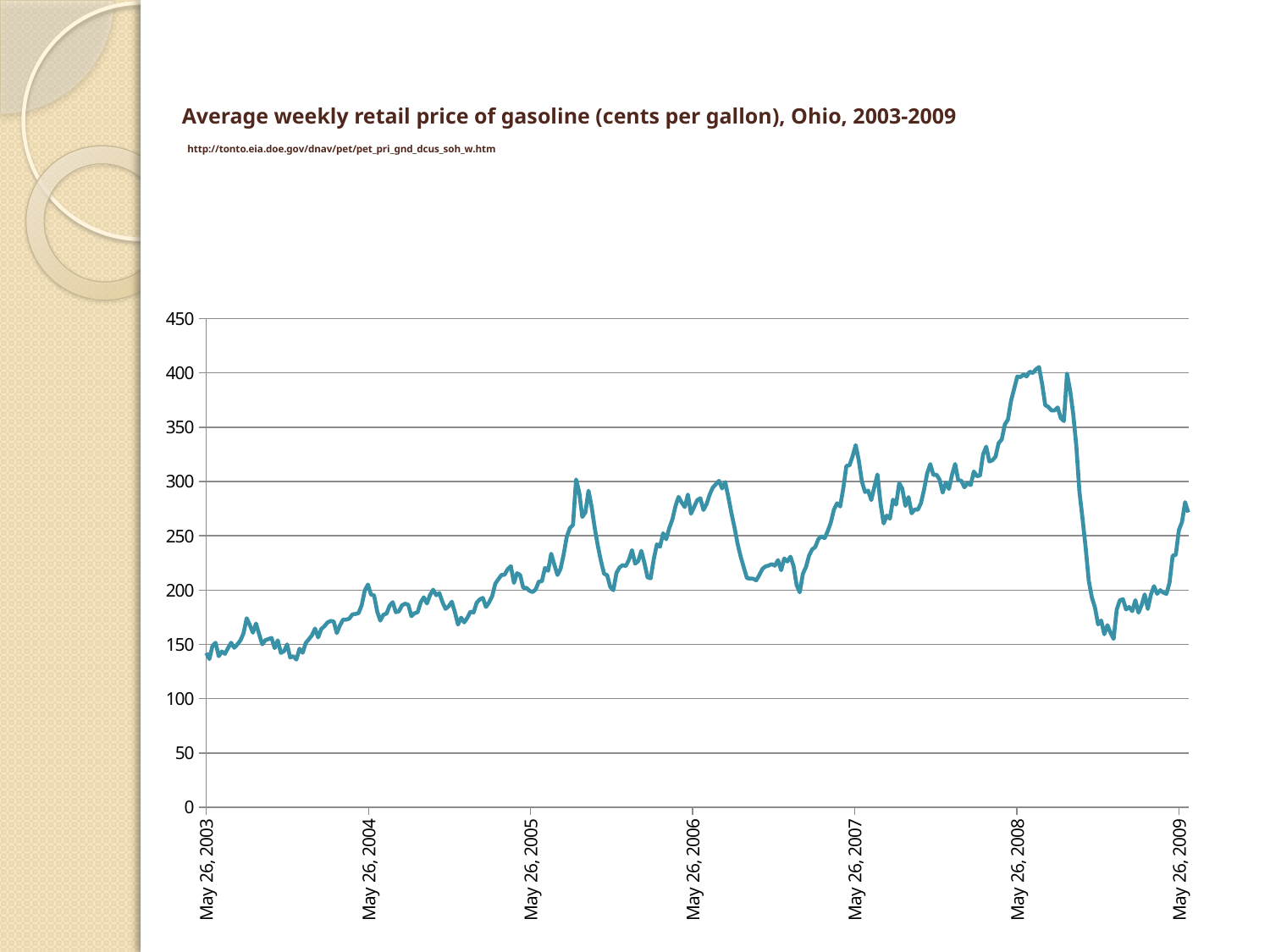
Is the value at May 26, 2007 greater or less than 300? greater How many date labels are shown on the x axis? 7 In which year does the line reach its highest point? 2008 Does the price generally rise or fall from May 26, 2003 to May 26, 2008? rise What is the title of the chart? Average weekly retail price of gasoline (cents per gallon), Ohio, 2003-2009 Does the price rise or fall in the months immediately after its peak in 2008? fall What kind of chart is shown on the slide? line chart Is the value at May 26, 2003 greater or less than 200? less Is the value at May 26, 2004 greater or less than 250? less